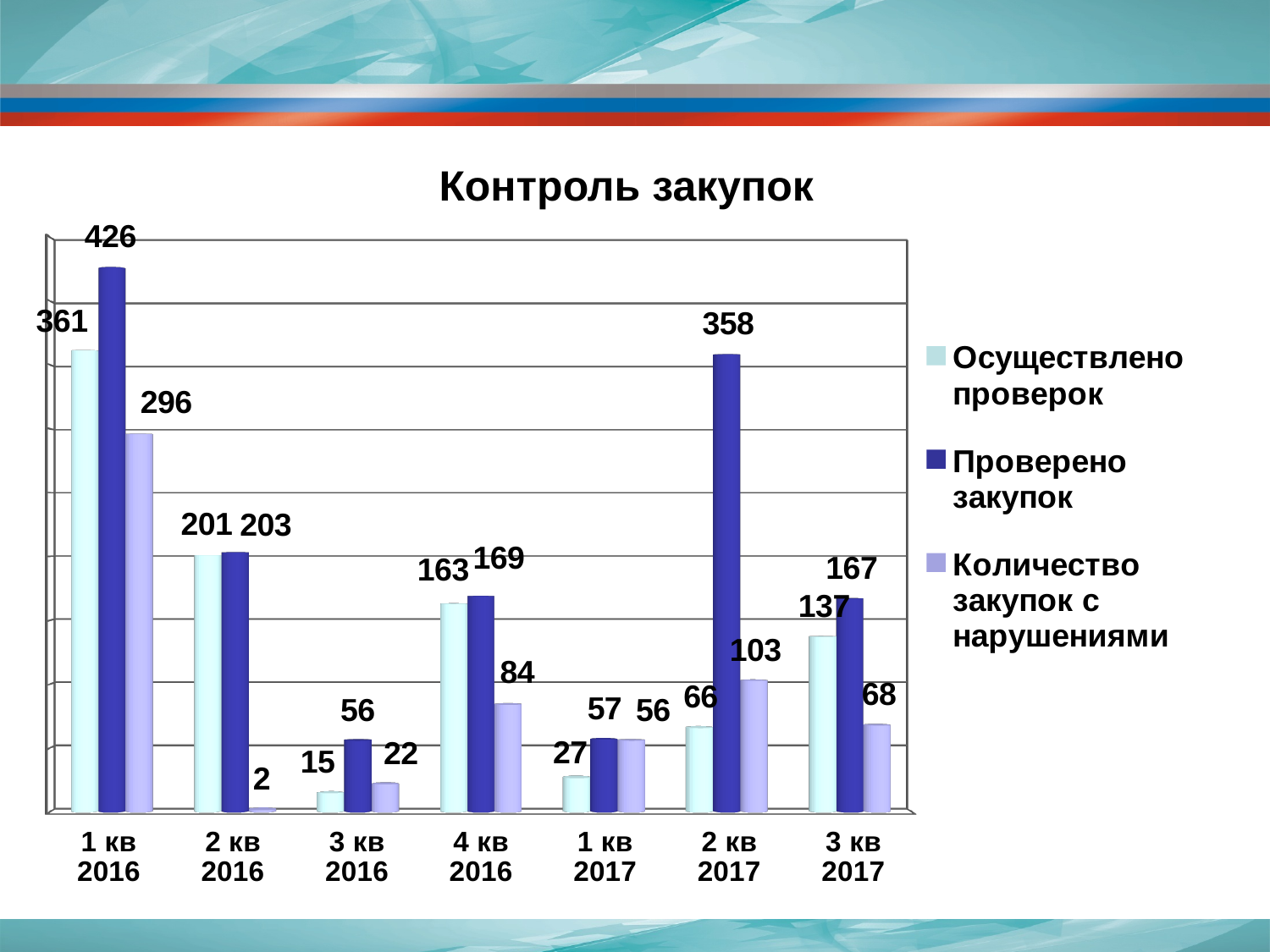
What is the value of Количество закупок с нарушениями for 2 кв 2016? 2 In which quarter is Осуществлено проверок lowest? 3 кв 2016 How many quarters (categories) are shown on the x axis? 7 What kind of chart is shown on the slide? bar chart What is the title of the chart? Контроль закупок In which quarter is Проверено закупок highest? 1 кв 2016 What is the difference between Проверено закупок and Осуществлено проверок in 1 кв 2016? 65 What is the value of Количество закупок с нарушениями for 3 кв 2017? 68 Which is larger in 1 кв 2017: Проверено закупок or Осуществлено проверок? Проверено закупок What is the value of Осуществлено проверок for 4 кв 2016? 163 How many series does the legend list? 3 What is the value of Проверено закупок for 2 кв 2017? 358